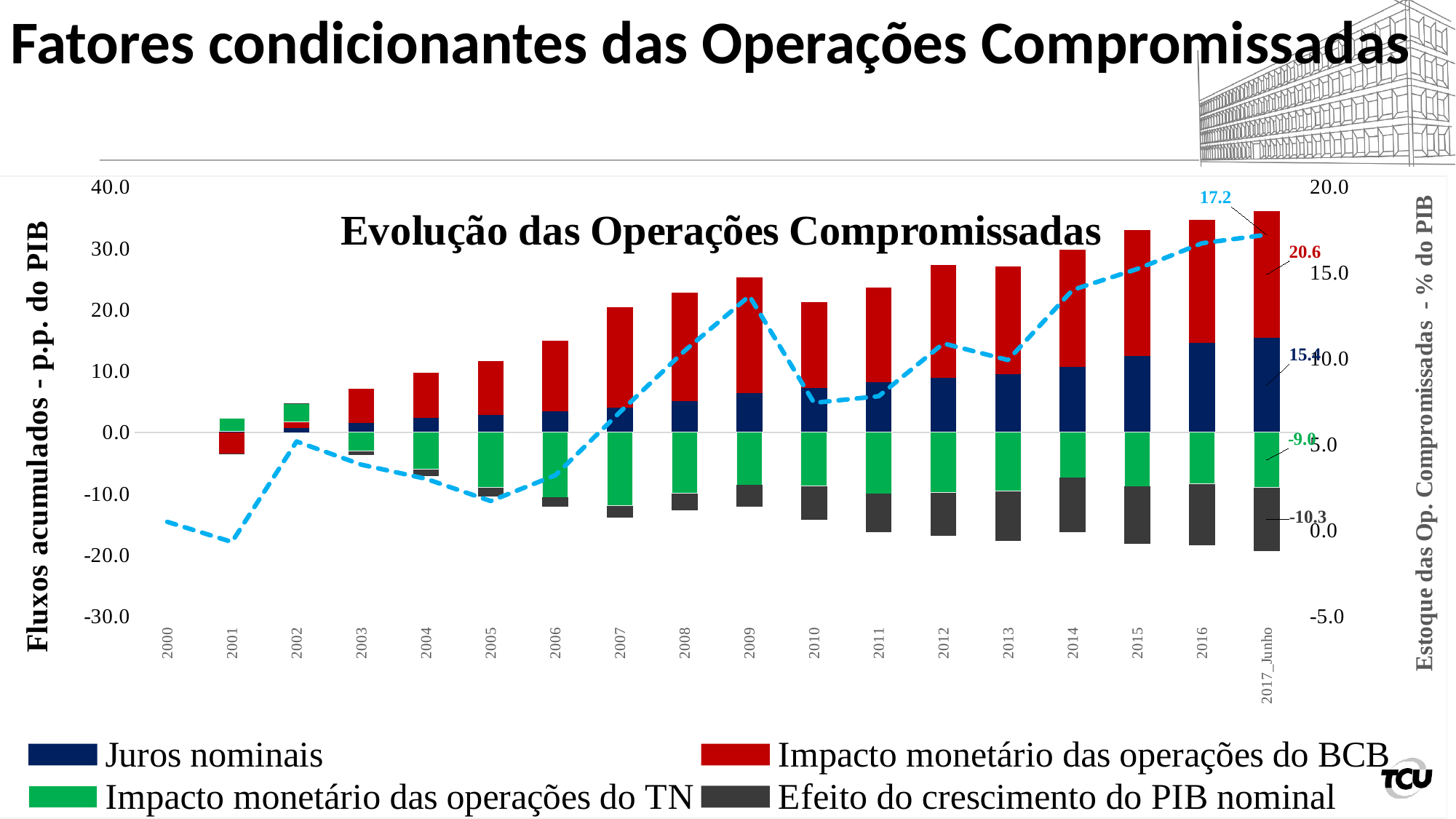
Is the top of the stacked bar for 2009 greater or less than 20.0? greater For 2017_Junho, which is larger: Juros nominais or Impacto monetário das operações do BCB? Impacto monetário das operações do BCB How many categories are shown on the x axis? 18 For 2017_Junho, what is the difference between Impacto monetário das operações do BCB and Juros nominais? 5.1 What value does the dashed line reach at 2017_Junho? 17.2 How many series does the chart legend list? 4 What kind of chart is used for the four legend series? bar chart What is the value of Impacto monetário das operações do TN for 2017_Junho? -9.0 What is the value of Efeito do crescimento do PIB nominal for 2017_Junho? -10.3 What is the value of Impacto monetário das operações do BCB for 2017_Junho? 20.6 What is the title of the chart? Evolução das Operações Compromissadas What is the value of Juros nominais for 2017_Junho? 15.4